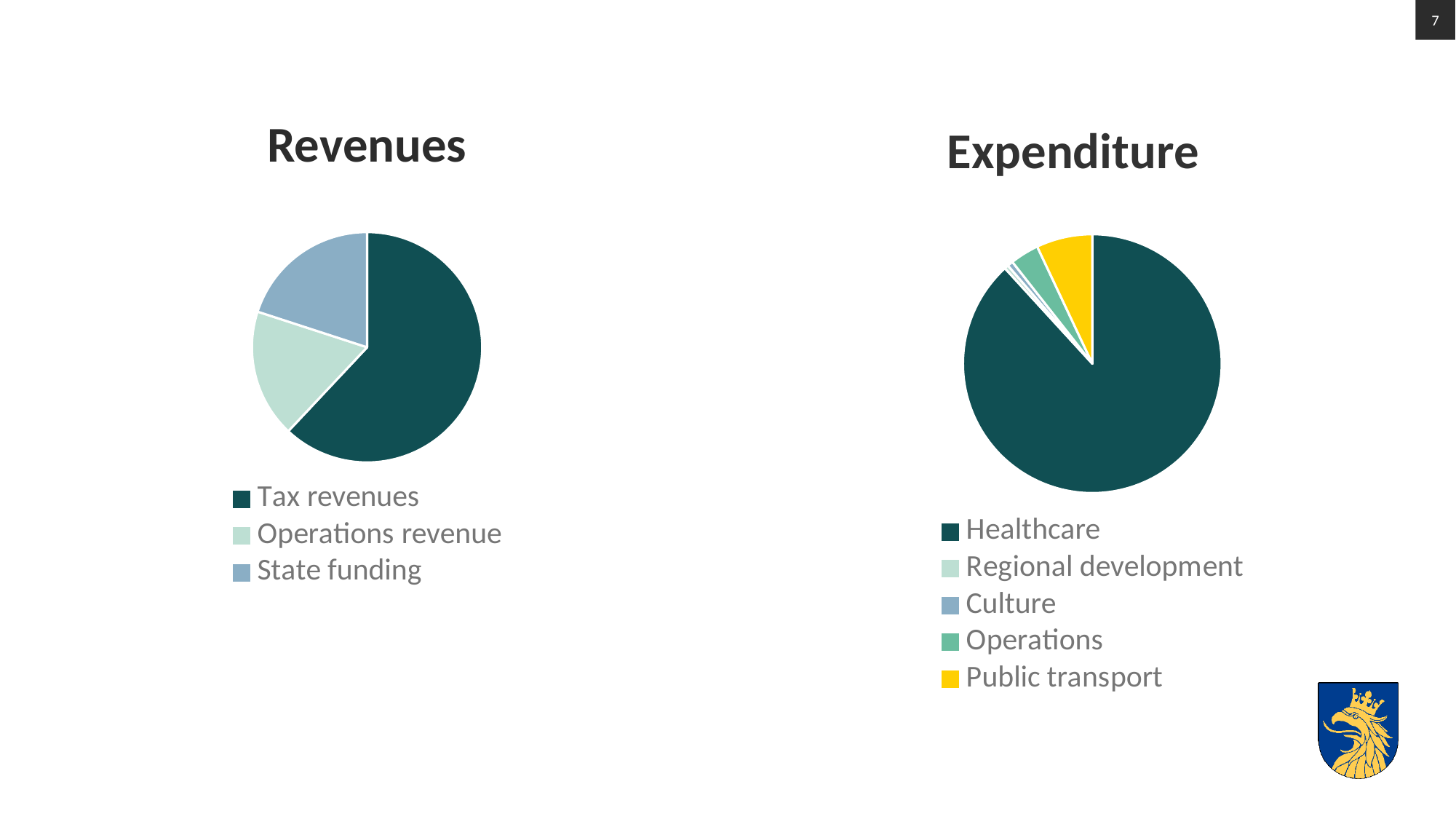
In the Expenditure chart, which category is shown in yellow? Public transport In the Expenditure chart, which slice is larger: Operations or Culture? Operations What kind of chart is the Revenues chart? Pie chart In the Revenues chart, which slice is larger: Tax revenues or State funding? Tax revenues What kind of chart is the Expenditure chart? Pie chart In the Expenditure chart, which category has the largest slice? Healthcare How many categories does the Expenditure pie chart show? 5 How many categories does the Revenues pie chart show? 3 In the Expenditure chart, which slice is larger: Healthcare or Public transport? Healthcare What is the title of the chart on the left side of the slide? Revenues In the Revenues chart, which category has the largest slice? Tax revenues